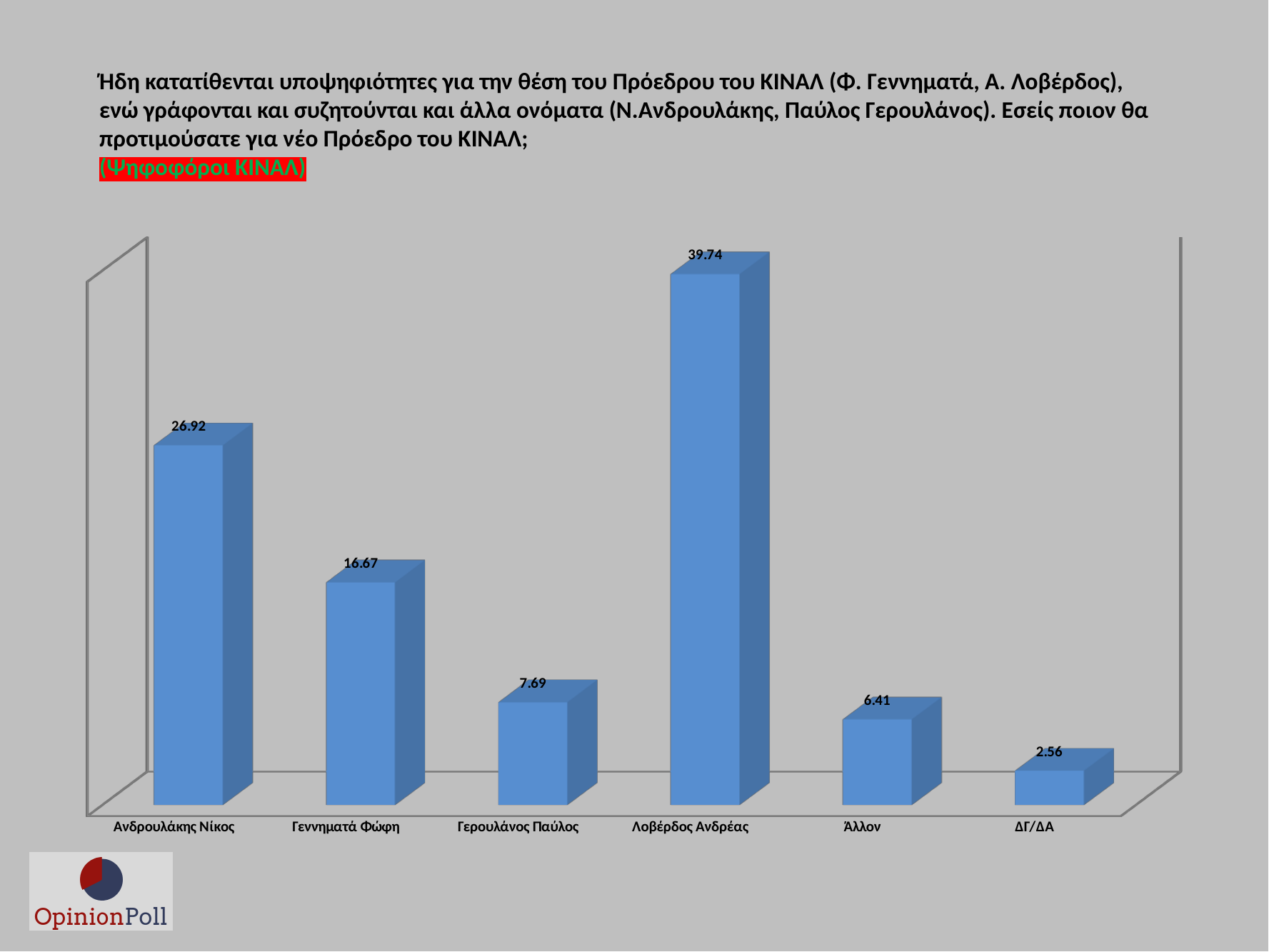
What is the value shown for ΔΓ/ΔΑ? 2.56 Which category has the lowest value? ΔΓ/ΔΑ What kind of chart is shown on the slide? Bar chart What is the value shown for Λοβέρδος Ανδρέας? 39.74 Which is larger, the value for Γερουλάνος Παύλος or the value for Άλλον? Γερουλάνος Παύλος What colour are the bars in the chart? Blue Which category has the highest value? Λοβέρδος Ανδρέας What is the difference between the values for Ανδρουλάκης Νίκος and Γεννηματά Φώφη? 10.25 What is the value shown for Ανδρουλάκης Νίκος? 26.92 What is the difference between the values for Λοβέρδος Ανδρέας and Ανδρουλάκης Νίκος? 12.82 What is the value shown for Γεννηματά Φώφη? 16.67 How many categories are shown on the chart? 6